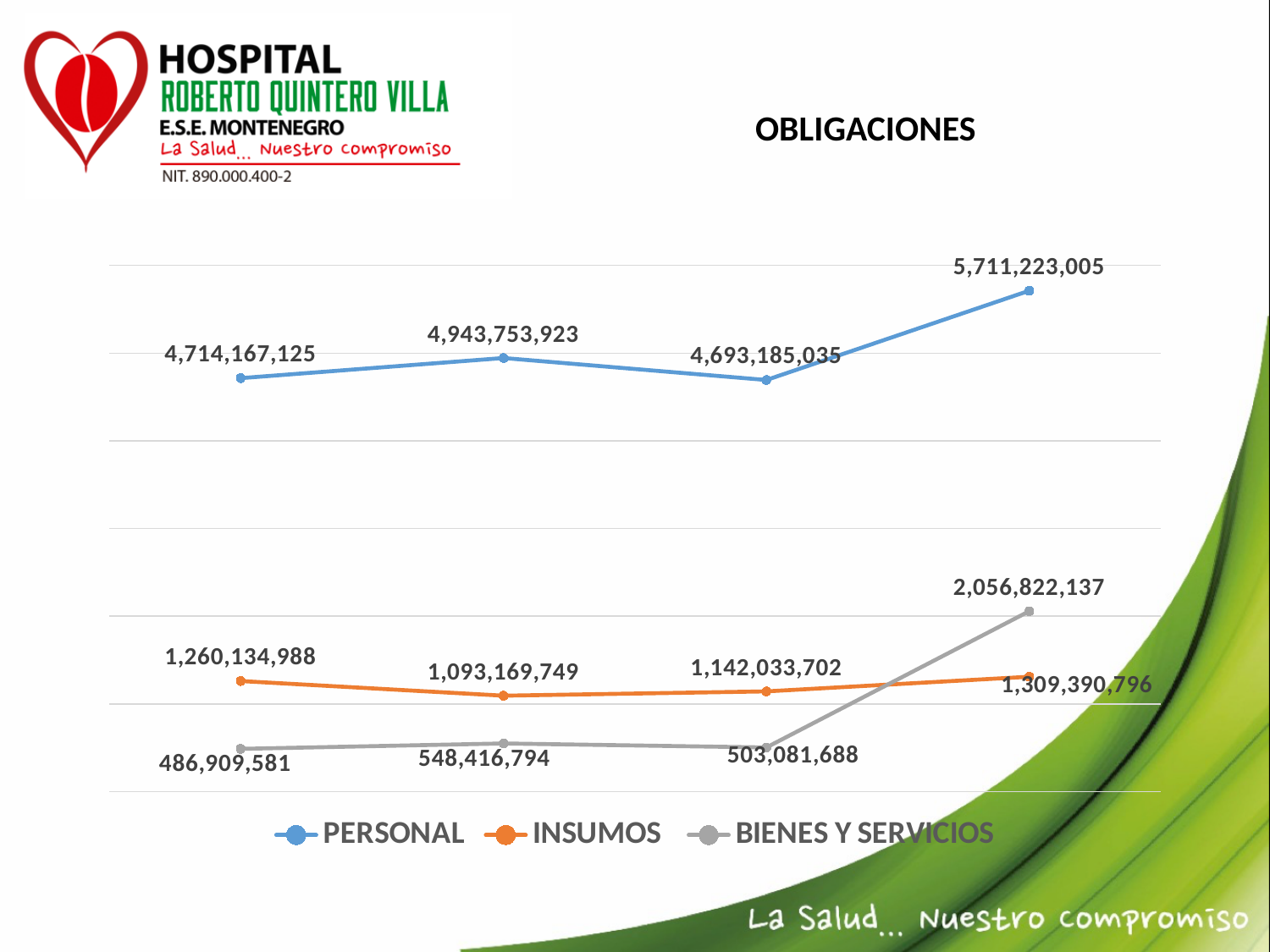
What is the difference between the fourth and third points of the BIENES Y SERVICIOS series? 1,553,740,449 What colour is the line for the INSUMOS series? orange How many data points does each series in the OBLIGACIONES chart have? 4 What type of chart is shown on the OBLIGACIONES slide? line chart What is the value of the last (rightmost) point of the PERSONAL series? 5,711,223,005 Which series has the highest values across the OBLIGACIONES chart? PERSONAL How many series does the legend of the OBLIGACIONES chart list? 3 What is the value of the second point of the BIENES Y SERVICIOS series? 548,416,794 Which point of the INSUMOS series has the lowest value? 1,093,169,749 What is the value of the first (leftmost) point of the INSUMOS series? 1,260,134,988 What is the difference between the last and first points of the PERSONAL series? 997,055,880 At the last point, which is larger: INSUMOS or BIENES Y SERVICIOS? BIENES Y SERVICIOS